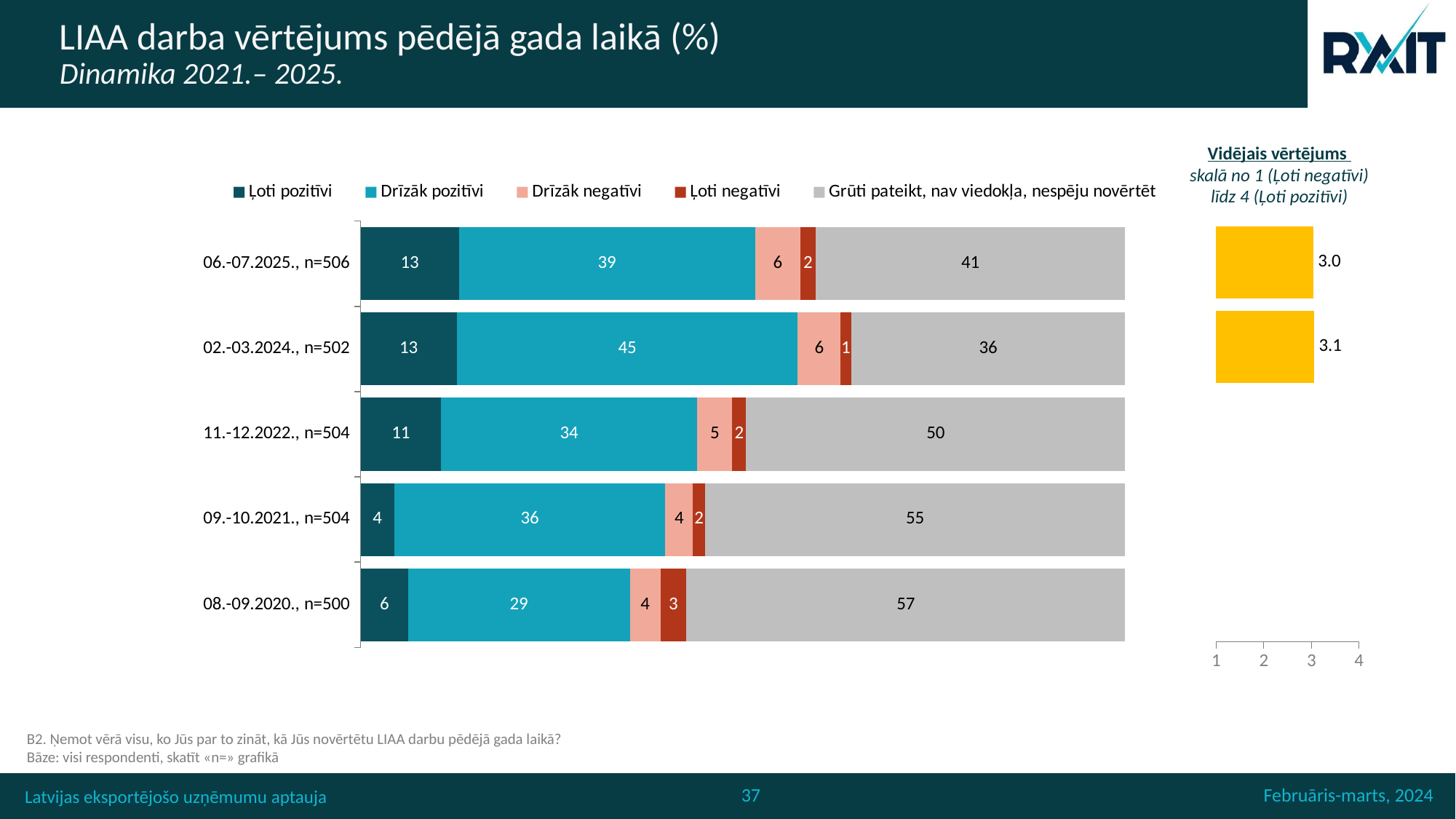
In the main stacked bar chart, what is the difference between the 'Drīzāk pozitīvi' values for 02.-03.2024., n=502 and 06.-07.2025., n=506? 6 In the 'Vidējais vērtējums' chart on the right, which period has the higher average rating? 02.-03.2024., n=502 In the main stacked bar chart, which period has the lowest value for 'Drīzāk pozitīvi'? 08.-09.2020., n=500 In the main stacked bar chart, what is the value for 'Drīzāk pozitīvi' in 02.-03.2024., n=502? 45 How many series does the legend of the main stacked bar chart list? 5 In the main stacked bar chart, which period has the highest value for 'Grūti pateikt, nav viedokļa, nespēju novērtēt'? 08.-09.2020., n=500 What kind of chart is the main chart on the slide? Stacked bar chart In the 'Vidējais vērtējums' chart on the right, what is the average rating for 06.-07.2025., n=506? 3.0 In the main stacked bar chart, what is the value for 'Grūti pateikt, nav viedokļa, nespēju novērtēt' in 08.-09.2020., n=500? 57 In the main stacked bar chart, what is the value for 'Ļoti pozitīvi' in 09.-10.2021., n=504? 4 In the main stacked bar chart, is the 'Ļoti pozitīvi' value larger for 11.-12.2022., n=504 or for 08.-09.2020., n=500? 11.-12.2022., n=504 How many periods (bars) are shown in the main stacked bar chart? 5